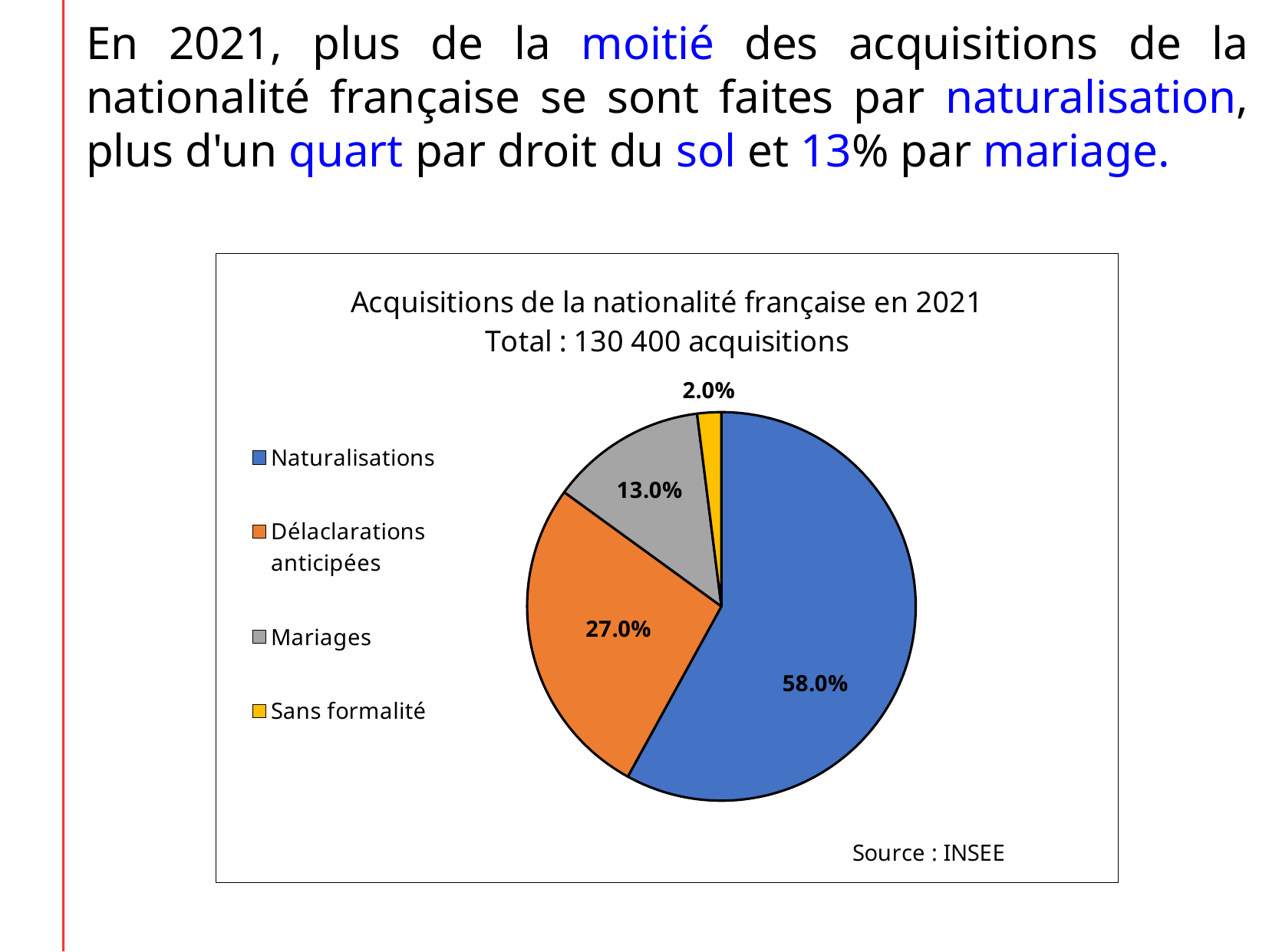
Which category has the smallest slice of the pie? Sans formalité What is the difference in percentage points between Naturalisations and Délaclarations anticipées? 31.0 What share of acquisitions is labelled for Sans formalité? 2.0% What share of acquisitions is labelled for Mariages? 13.0% Which is larger, the share for Mariages or the share for Sans formalité? Mariages What share of acquisitions is labelled for Délaclarations anticipées? 27.0% What total number of acquisitions is stated in the chart title? 130 400 acquisitions What source is cited for the chart? INSEE How many categories does the pie chart show? 4 What share of acquisitions is labelled for Naturalisations? 58.0% What kind of chart is shown on the slide? pie chart Which category has the largest slice of the pie? Naturalisations